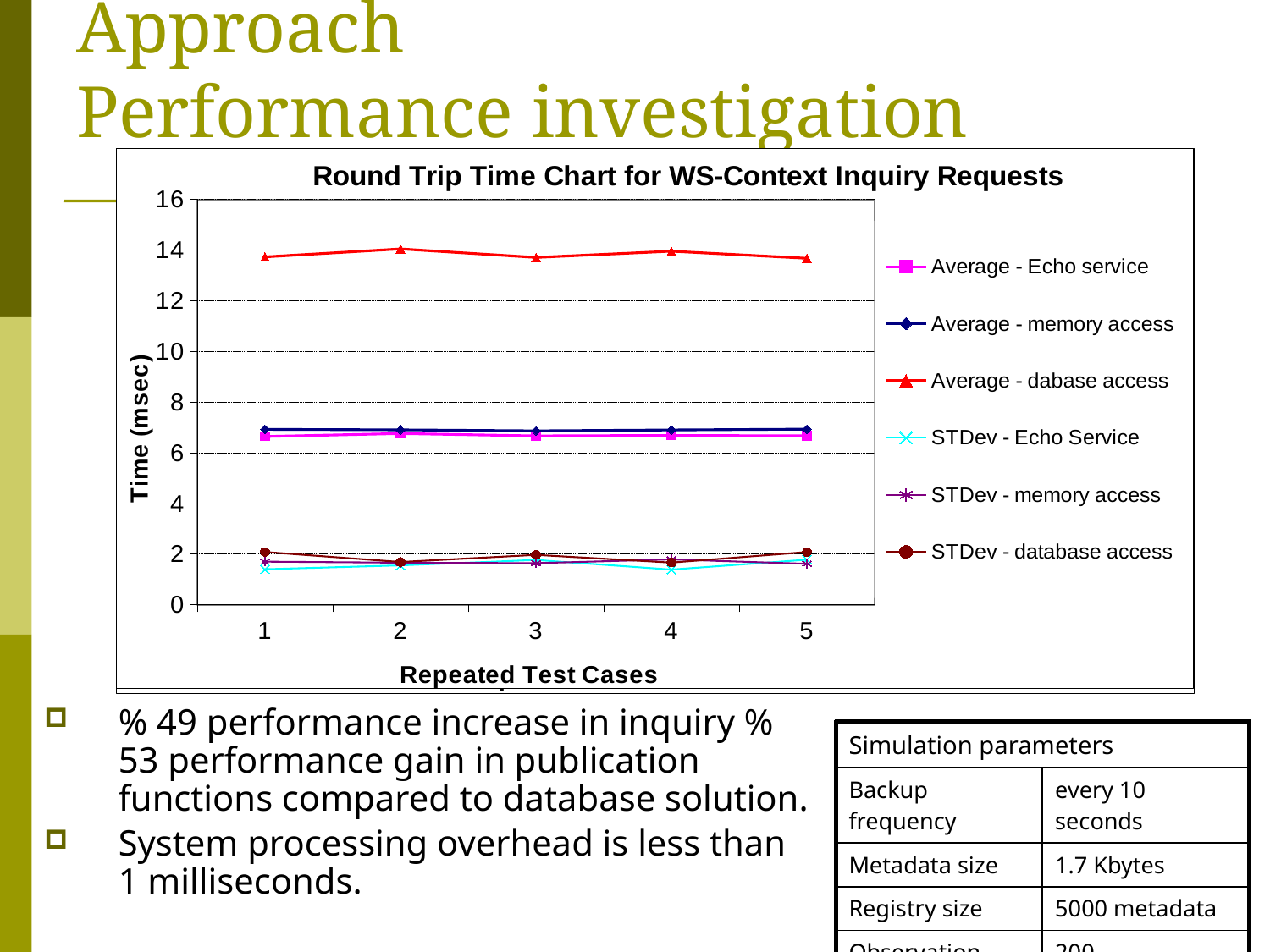
Which series has the highest values across all test cases? Average - dabase access How many series does the legend list? 6 At test case 3, which is larger: Average - dabase access or Average - Echo service? Average - dabase access At test case 5, which is larger: Average - memory access or STDev - memory access? Average - memory access Is the value for Average - Echo service at test case 3 greater or less than 6? greater What kind of chart is shown on the slide? line chart What is the label of the y axis? Time (msec) Is the value for Average - memory access at test case 2 greater or less than 8? less What is the title of the chart? Round Trip Time Chart for WS-Context Inquiry Requests Is the value for Average - dabase access at test case 1 greater or less than 12? greater How many repeated test cases are plotted along the x axis? 5